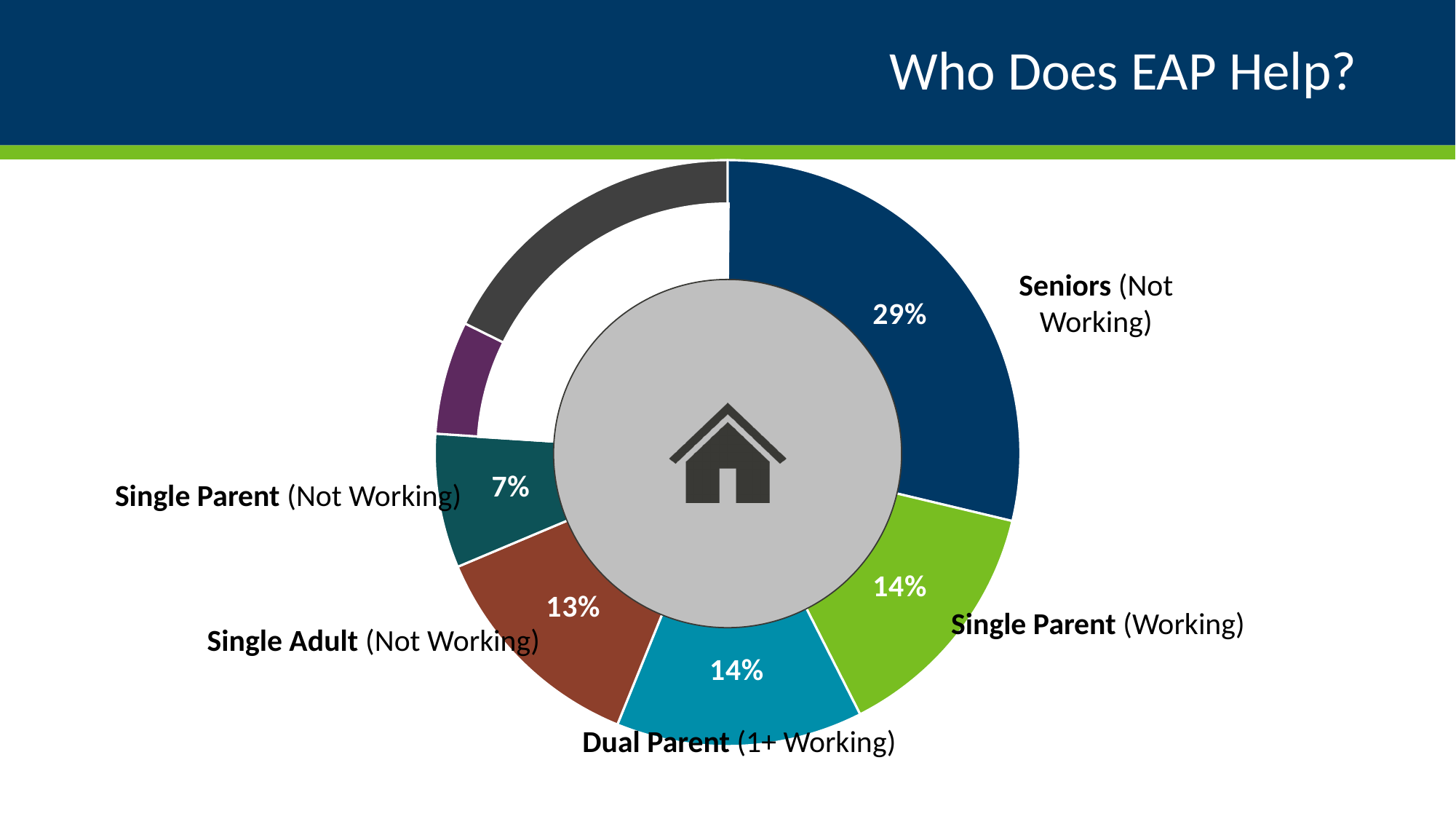
What percentage is labeled for Single Adult (Not Working)? 13% Which labeled group has the largest share of the pie chart? Seniors (Not Working) What is the title of the slide containing the chart? Who Does EAP Help? Among the labeled slices, which group has the smallest share? Single Parent (Not Working) What percentage of the pie chart is Seniors (Not Working)? 29% What percentage is shown for Single Parent (Not Working)? 7% What is the difference between the Seniors (Not Working) share and the Single Parent (Working) share? 15 percentage points How many percentage points larger is the Seniors (Not Working) share than the Single Parent (Not Working) share? 22 percentage points What percentage does the Single Parent (Working) slice show? 14% Which is larger, the share for Seniors (Not Working) or the share for Single Adult (Not Working)? Seniors (Not Working) What type of chart is shown on the slide? Doughnut chart What is the value shown for Dual Parent (1+ Working)? 14%